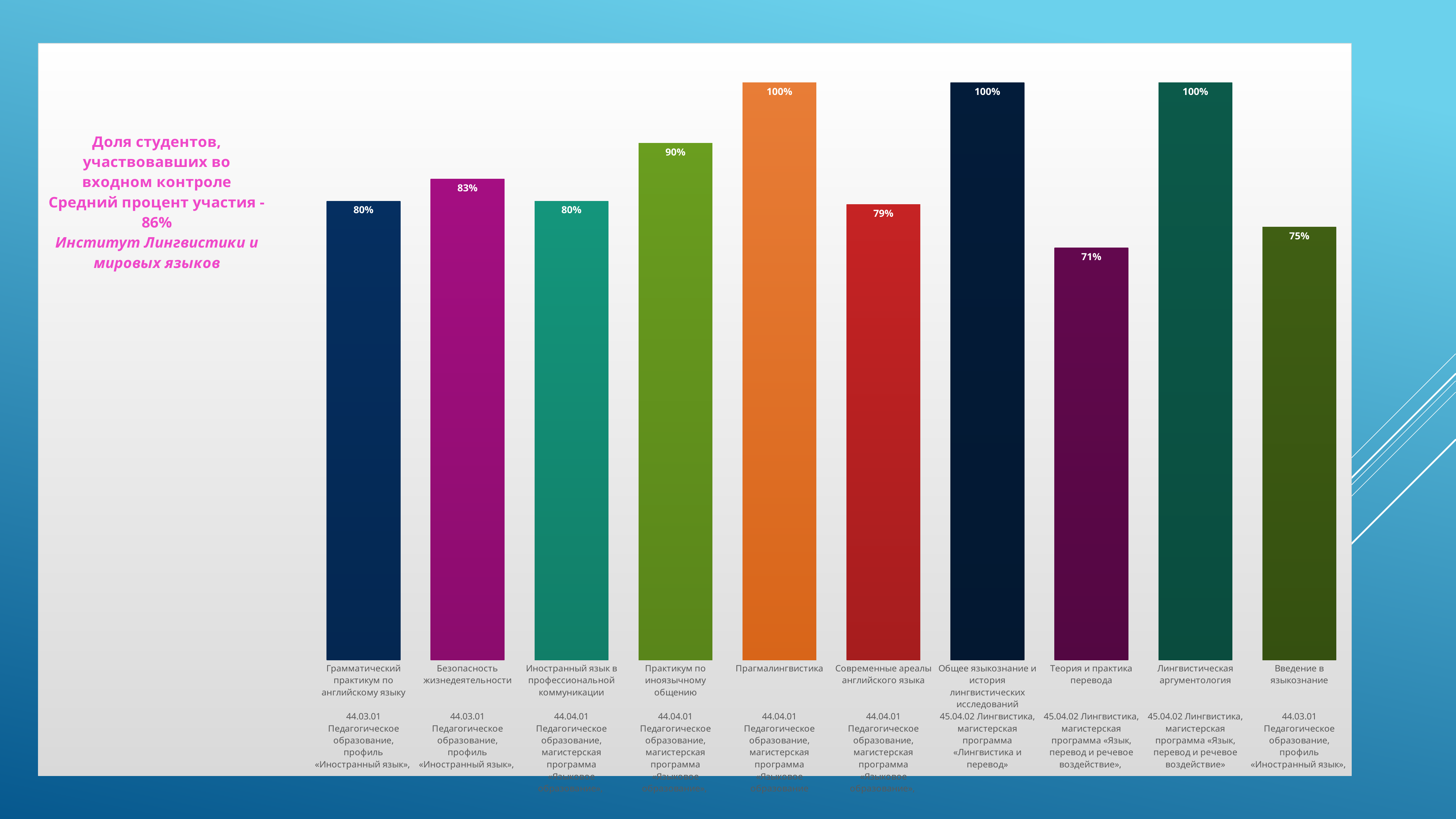
What average participation percentage is stated in the chart's text block? 86% How many disciplines have a value of 100%? 3 Which is larger: the value for «Безопасность жизнедеятельности» or the value for «Введение в языкознание»? Безопасность жизнедеятельности What is the value for «Современные ареалы английского языка»? 79% Which discipline has the lowest share of students who took part in the entrance control? Теория и практика перевода How many bars (disciplines) are plotted in the chart? 10 What is the value for «Безопасность жизнедеятельности»? 83% What is the difference between the values for «Практикум по иноязычному общению» and «Теория и практика перевода»? 19% What is the value for «Практикум по иноязычному общению»? 90% What is the value for «Теория и практика перевода»? 71% What type of chart is shown on the slide? bar chart What is the value for «Введение в языкознание»? 75%